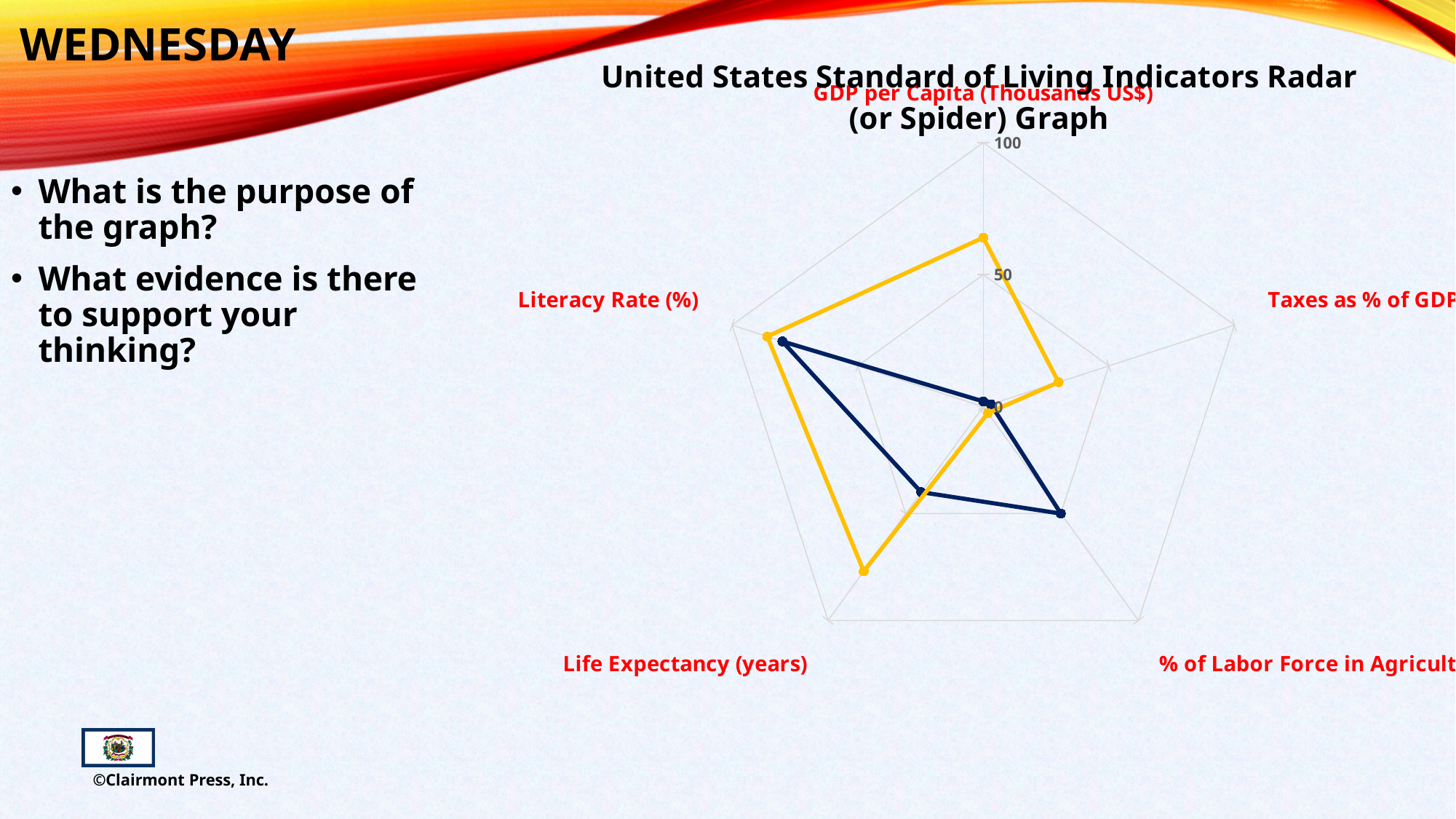
Is the dark blue series' value for GDP per Capita (Thousands US$) greater or less than 50? less For GDP per Capita (Thousands US$), which series has the larger value, the yellow or the dark blue? Yellow Is the yellow series' value for Taxes as % of GDP greater or less than 50? less For Life Expectancy (years), which series has the larger value, the yellow or the dark blue? Yellow Is the yellow series' value for Life Expectancy (years) greater or less than 50? greater What kind of chart is shown on the slide? Radar chart How many indicator axes does the radar chart have? 5 What is the title of the chart? United States Standard of Living Indicators Radar (or Spider) Graph What is the highest value shown on the radar chart's axis scale? 100